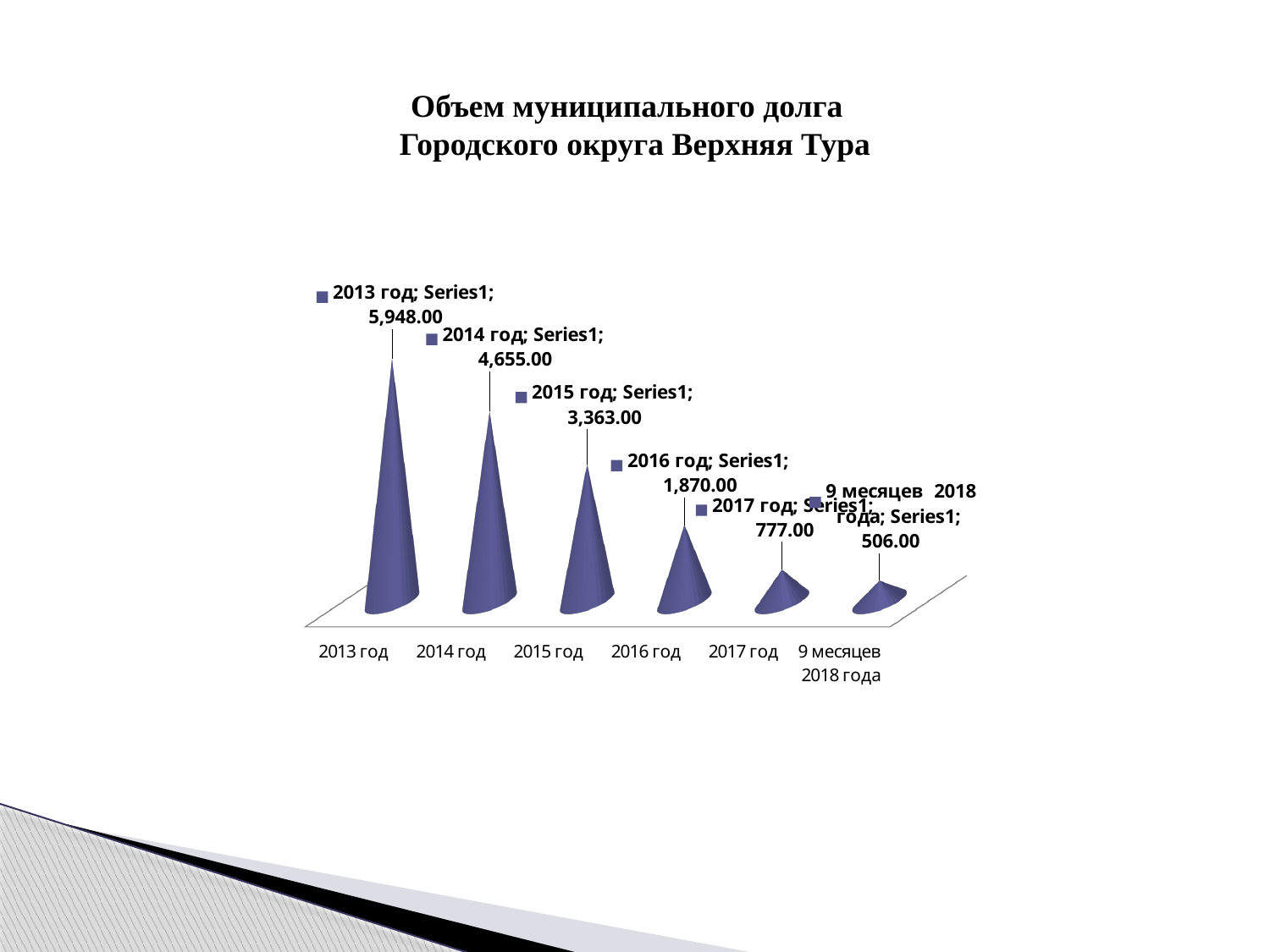
What is the difference between the values for 2013 год and 2014 год? 1,293.00 What is the value for 9 месяцев 2018 года? 506.00 What kind of chart is this? bar chart What is the title of the chart? Объем муниципального долга Городского округа Верхняя Тура Do the values rise or fall from 2013 год to 9 месяцев 2018 года? fall How many categories are shown on the x axis? 6 What is the value for 2013 год? 5,948.00 What is the difference between the values for 2016 год and 2017 год? 1,093.00 Which is larger, the value for 2014 год or the value for 2015 год? 2014 год What is the value for 2015 год? 3,363.00 Which category has the highest value? 2013 год Which category has the lowest value? 9 месяцев 2018 года